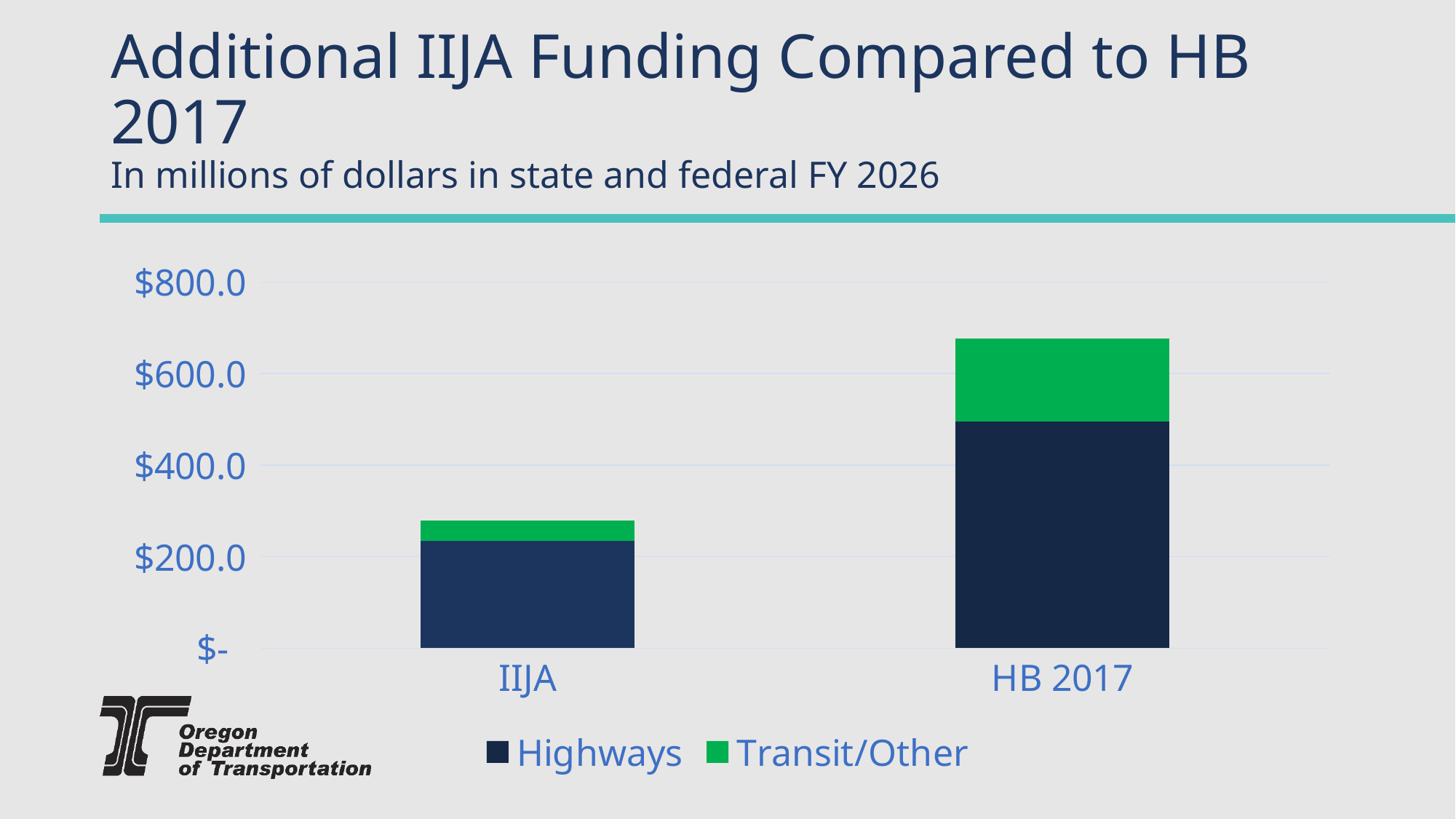
Is the total bar for HB 2017 greater or less than $800.0? less How many categories are shown on the x axis of the chart? 2 Is the total bar for IIJA greater or less than $200.0? greater Is the total bar for IIJA greater or less than $400.0? less Which category has the shorter total bar? IIJA What kind of chart is shown on the slide? Stacked bar chart How many series does the chart's legend list? 2 Which category has the taller total bar, IIJA or HB 2017? HB 2017 Which series is shown in green in the chart's legend? Transit/Other Which category has the larger Transit/Other segment, IIJA or HB 2017? HB 2017